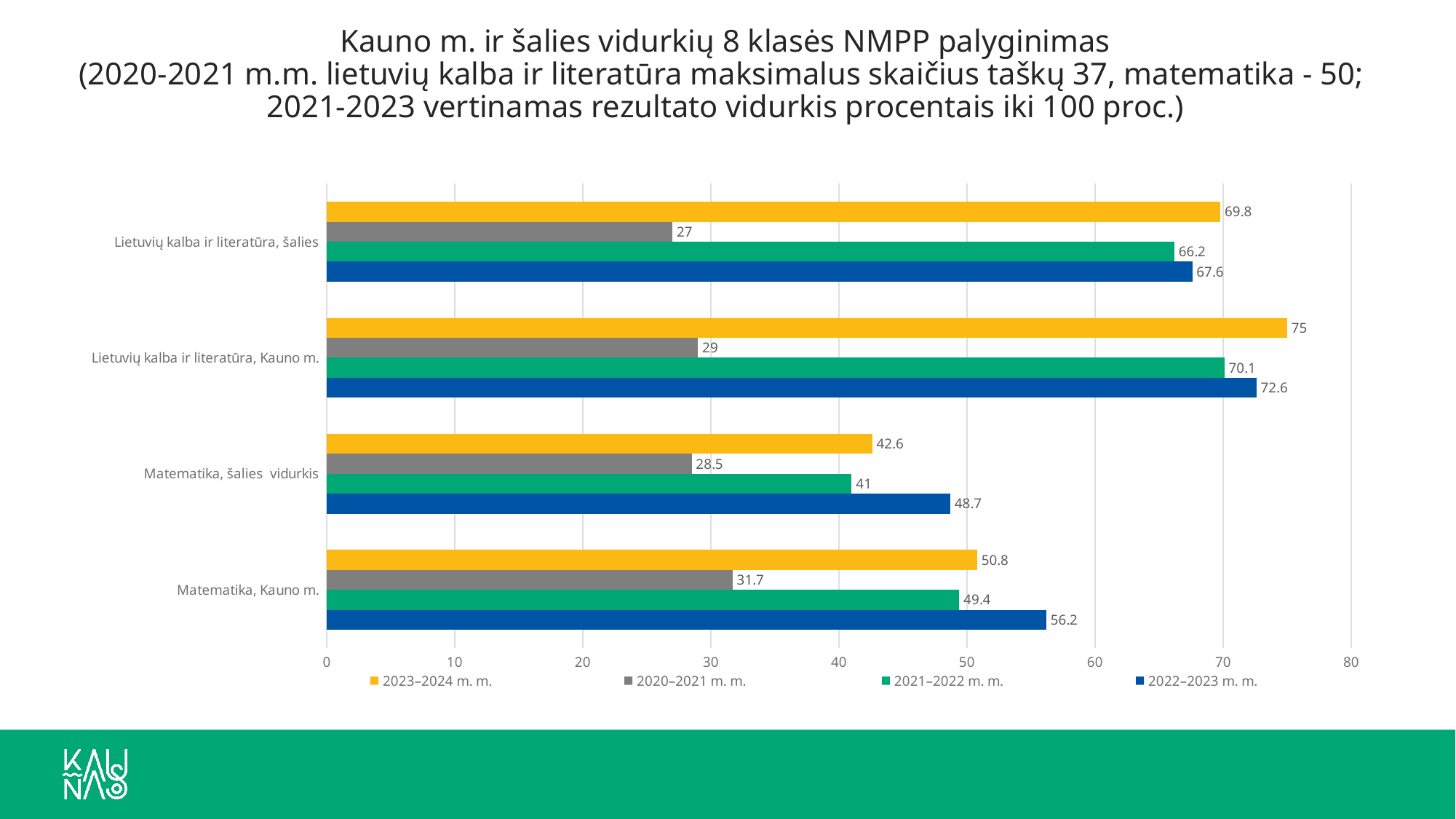
How many categories are shown on the chart? 4 Which is larger for Lietuvių kalba ir literatūra, šalies: the 2022–2023 m. m. value or the 2021–2022 m. m. value? 2022–2023 m. m. Which colour represents the 2021–2022 m. m. series? Green How many series does the legend list? 4 What kind of chart is shown on the slide? Bar chart Which category has the highest value in the 2023–2024 m. m. series? Lietuvių kalba ir literatūra, Kauno m. What is the value for Matematika, šalies vidurkis in the 2022–2023 m. m. series? 48.7 Which category has the lowest value in the 2020–2021 m. m. series? Lietuvių kalba ir literatūra, šalies What is the difference between the 2022–2023 m. m. values for Matematika, Kauno m. and Matematika, šalies vidurkis? 7.5 What is the value for Lietuvių kalba ir literatūra, šalies in the 2021–2022 m. m. series? 66.2 What is the value for Matematika, Kauno m. in the 2020–2021 m. m. series? 31.7 What is the value for Lietuvių kalba ir literatūra, Kauno m. in the 2023–2024 m. m. series? 75